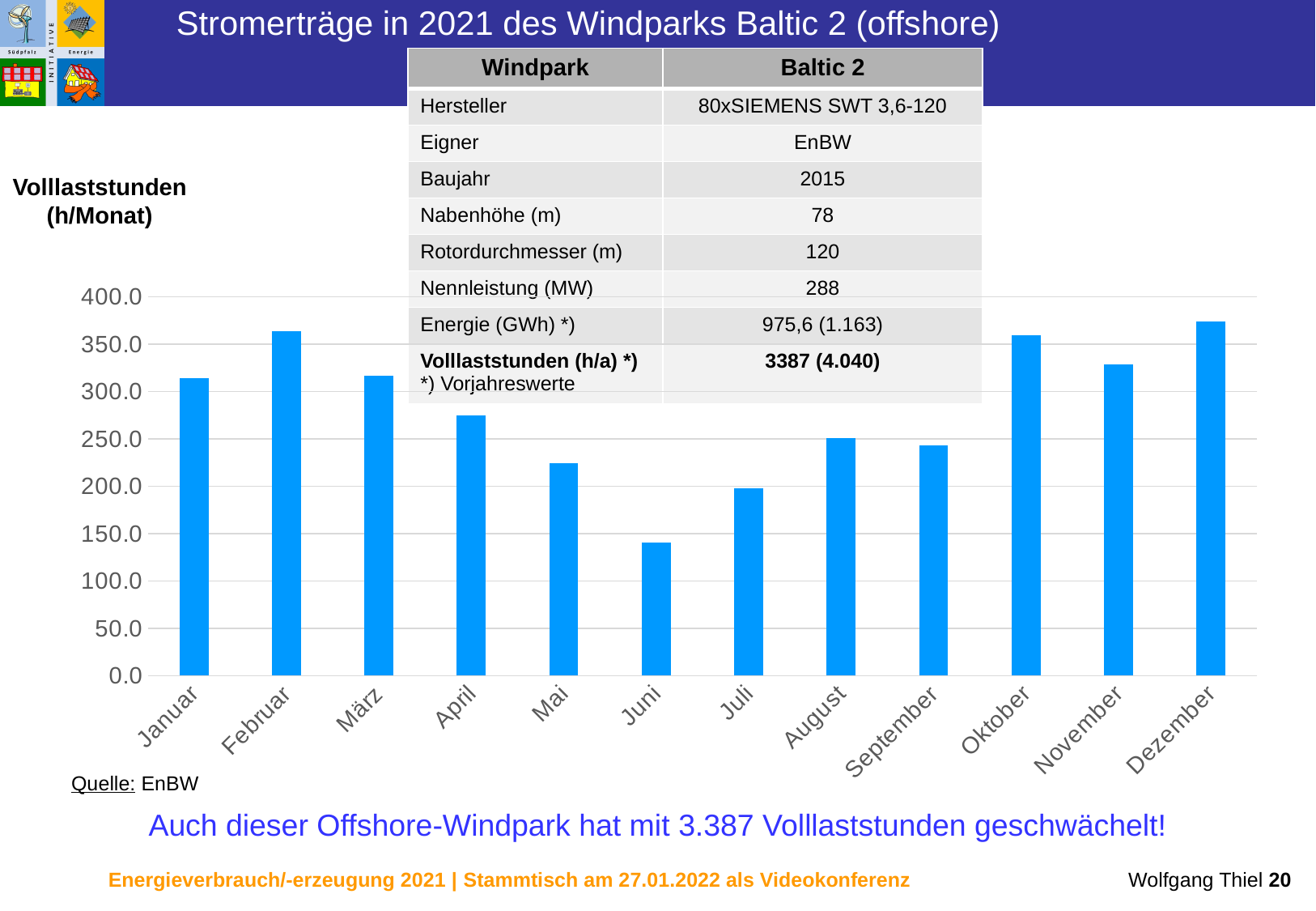
Which month has the larger value, Januar or Februar? Februar Which month has the highest Volllaststunden value in the chart? Dezember What quantity and unit does the chart's y axis label give? Volllaststunden (h/Monat) Which month has the lowest Volllaststunden value in the chart? Juni How many months are plotted on the x axis of the chart? 12 What kind of chart is shown on the slide? bar chart Do the values rise or fall from Januar to Juni? fall Is the value for April greater or less than 250? greater Is the value for Mai greater or less than 200? greater Is the value for November greater or less than 300? greater